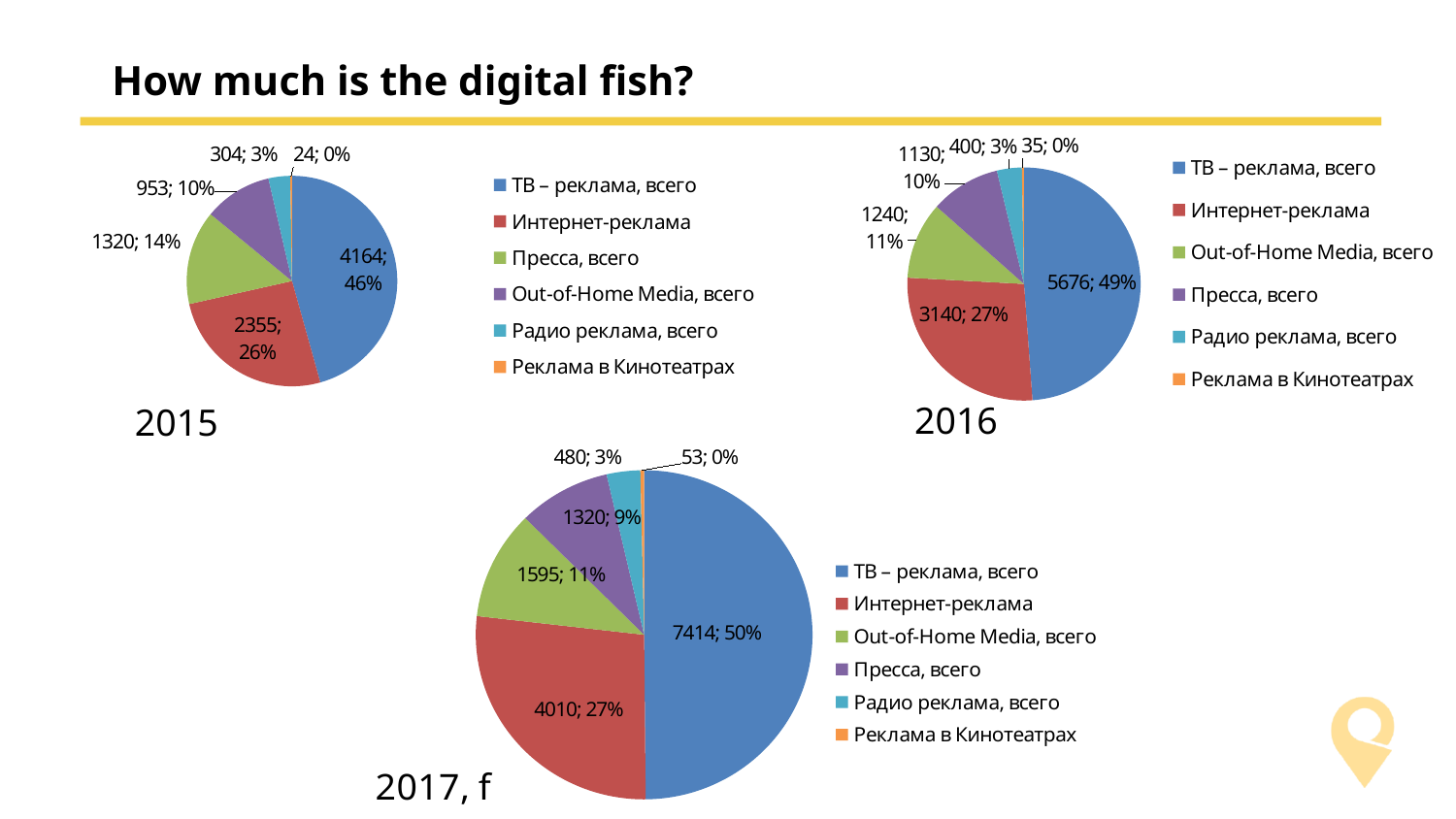
How many entries does the legend of the 2017, f chart list? 6 In the 2015 pie chart, what is the value shown for ТВ – реклама, всего? 4164; 46% In the 2017, f pie chart, what is the difference between the values for ТВ – реклама, всего and Интернет-реклама? 3404 In the 2015 pie chart, what is the value shown for Радио реклама, всего? 304; 3% In the 2016 pie chart, which is larger: Out-of-Home Media, всего or Пресса, всего? Out-of-Home Media, всего How many slices does the 2015 pie chart have? 6 In the 2016 pie chart, which category has the smallest value? Реклама в Кинотеатрах What kind of chart is used for the 2016 data? Pie chart In the 2017, f pie chart, what is the value shown for Out-of-Home Media, всего? 1595; 11% In the 2016 pie chart, what is the value shown for Интернет-реклама? 3140; 27% In the 2015 pie chart, which category has the largest value? ТВ – реклама, всего In the 2017, f pie chart, what share of the pie does ТВ – реклама, всего take? 50%